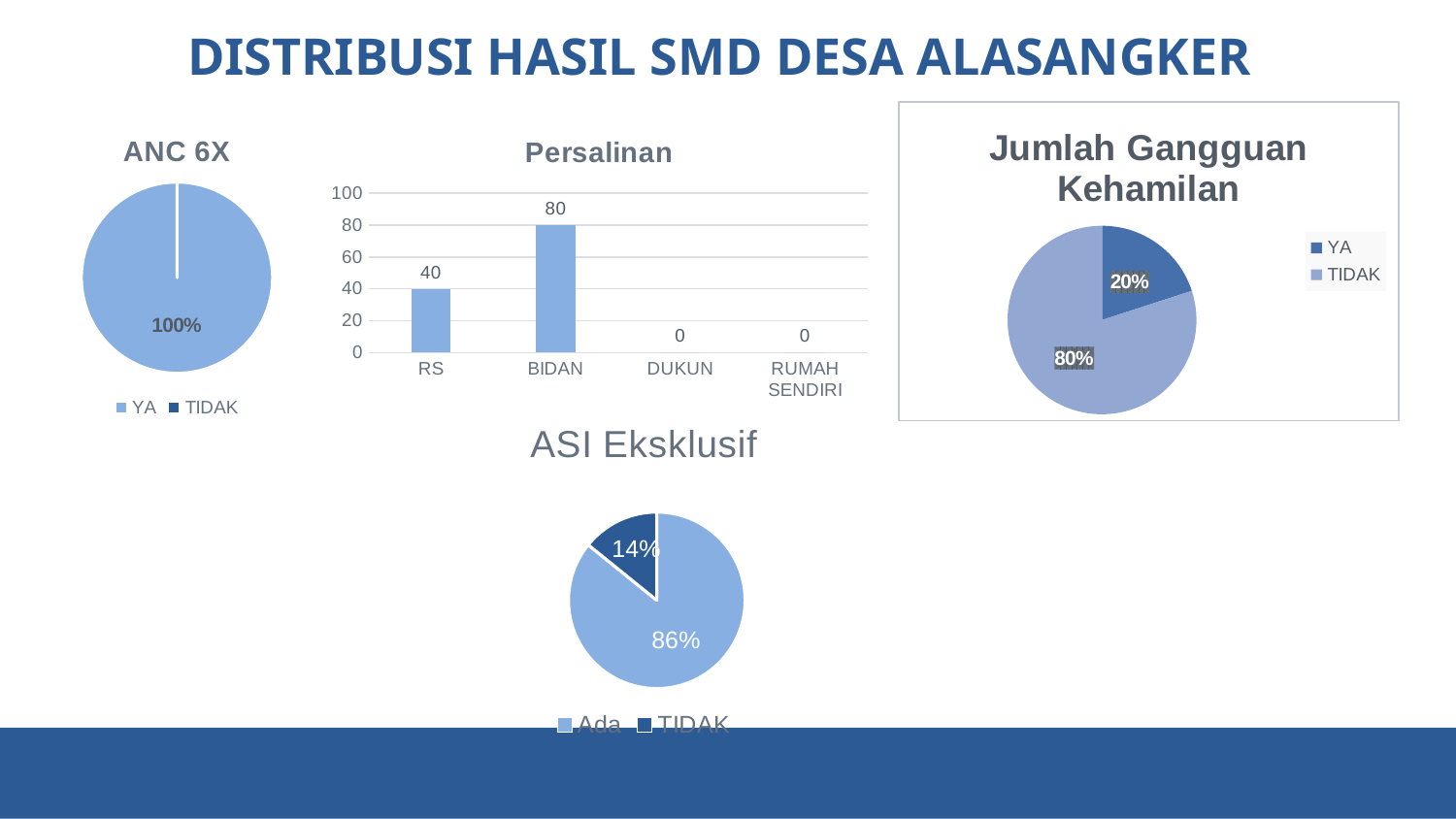
In the ANC 6X chart, what share does YA have? 100% What kind of chart is the Persalinan chart? bar chart In the Persalinan chart, how many categories are shown on the x axis? 4 In the Jumlah Gangguan Kehamilan chart, what share does YA have? 20% In the Persalinan chart, what is the value for DUKUN? 0 In the Persalinan chart, what is the difference between the values for BIDAN and RS? 40 In the Persalinan chart, which category has the highest value? BIDAN In the Persalinan chart, what is the value for BIDAN? 80 In the ASI Eksklusif chart, what share does TIDAK have? 14% How many series does the legend of the ASI Eksklusif chart list? 2 In the Persalinan chart, what is the value for RS? 40 In the Jumlah Gangguan Kehamilan chart, which slice is larger, YA or TIDAK? TIDAK